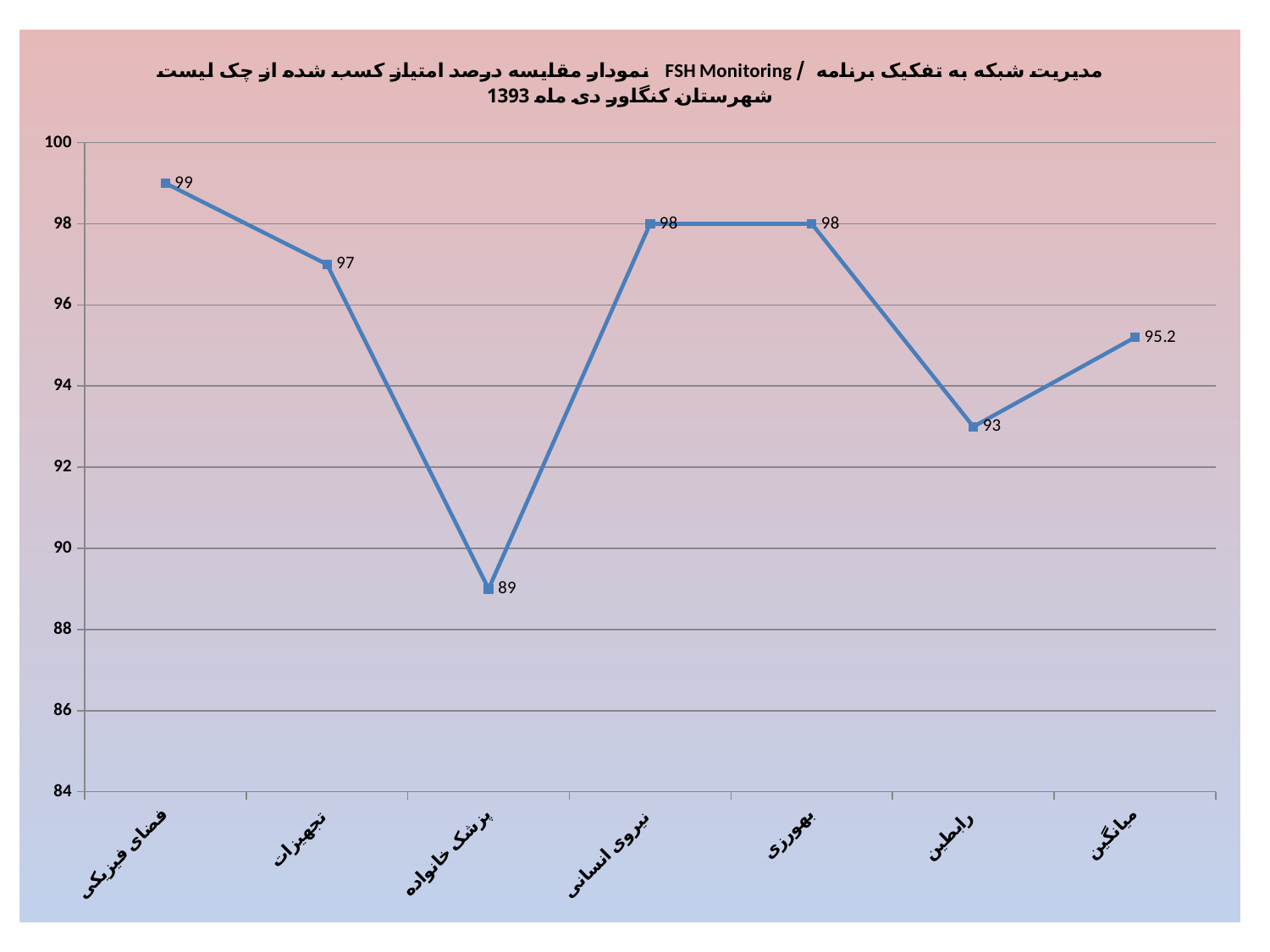
How many categories are plotted on the x axis? 7 What is the difference between the values for فضای فیزیکی and پزشک خانواده? 10 Do the values rise or fall from تجهیزات to پزشک خانواده? fall What is the value for پزشک خانواده? 89 Which category has the highest value? فضای فیزیکی Is the value for رابطین greater or less than 94? less What is the value for میانگین? 95.2 Which is larger, the value for تجهیزات or the value for رابطین? تجهیزات What is the value for رابطین? 93 What is the value for فضای فیزیکی? 99 What kind of chart is shown on the slide? line chart Which category has the lowest value? پزشک خانواده